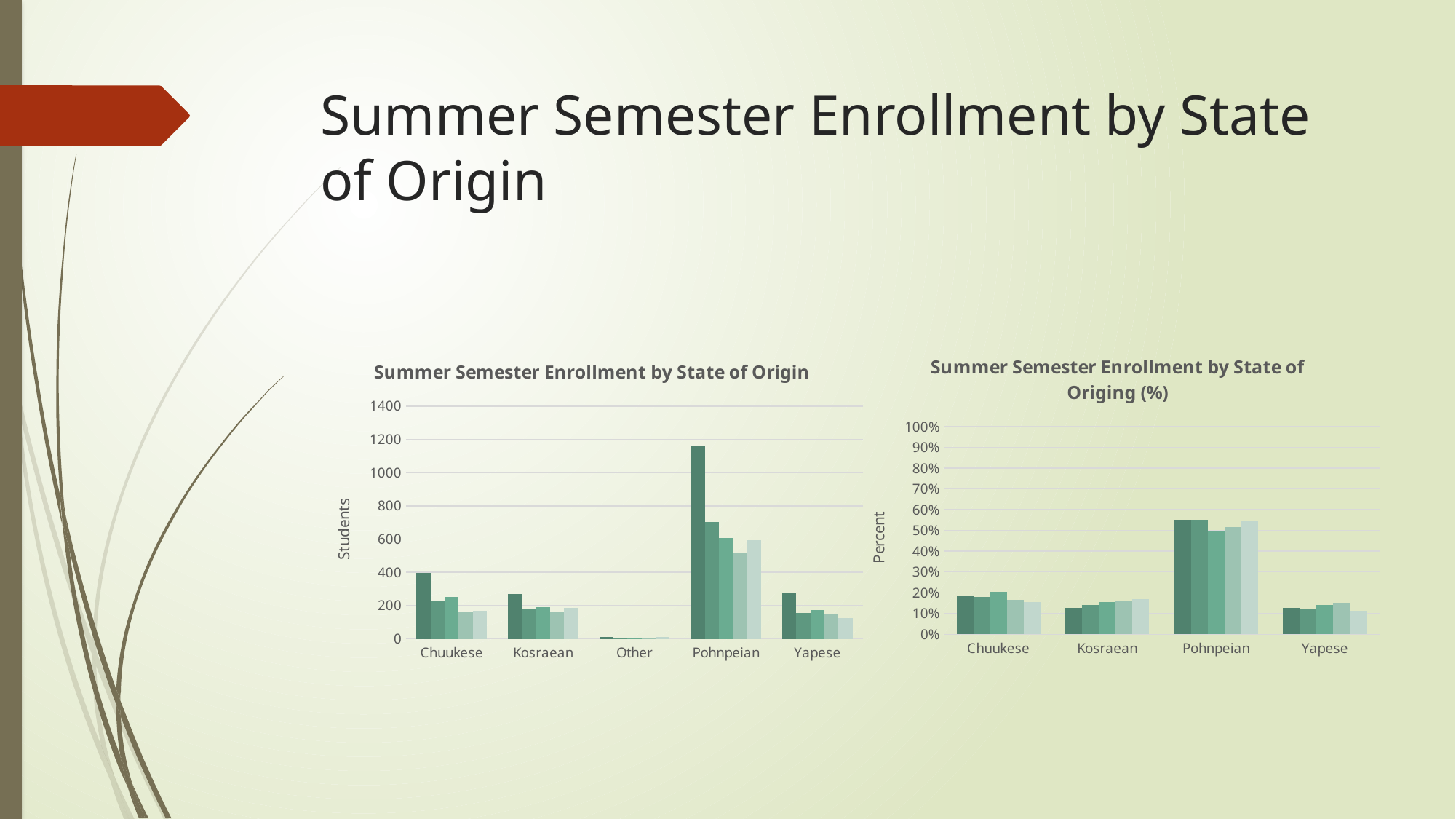
What type of chart is the left chart, 'Summer Semester Enrollment by State of Origin'? Bar chart In the right chart, 'Summer Semester Enrollment by State of Origing (%)', are the Pohnpeian bars greater or less than 40%? greater What is the y-axis title of the left chart, 'Summer Semester Enrollment by State of Origin'? Students In the left chart, 'Summer Semester Enrollment by State of Origin', which category has the tallest bar? Pohnpeian In the left chart, 'Summer Semester Enrollment by State of Origin', are all the Kosraean bars greater or less than 400? less In the right chart, 'Summer Semester Enrollment by State of Origing (%)', which category has the highest bars? Pohnpeian In the left chart, 'Summer Semester Enrollment by State of Origin', is the tallest Pohnpeian bar greater or less than 1000? greater How many categories are shown on the x axis of the right chart, 'Summer Semester Enrollment by State of Origing (%)'? 4 How many categories are shown on the x axis of the left chart, 'Summer Semester Enrollment by State of Origin'? 5 In the left chart, 'Summer Semester Enrollment by State of Origin', which category has the lowest bars? Other